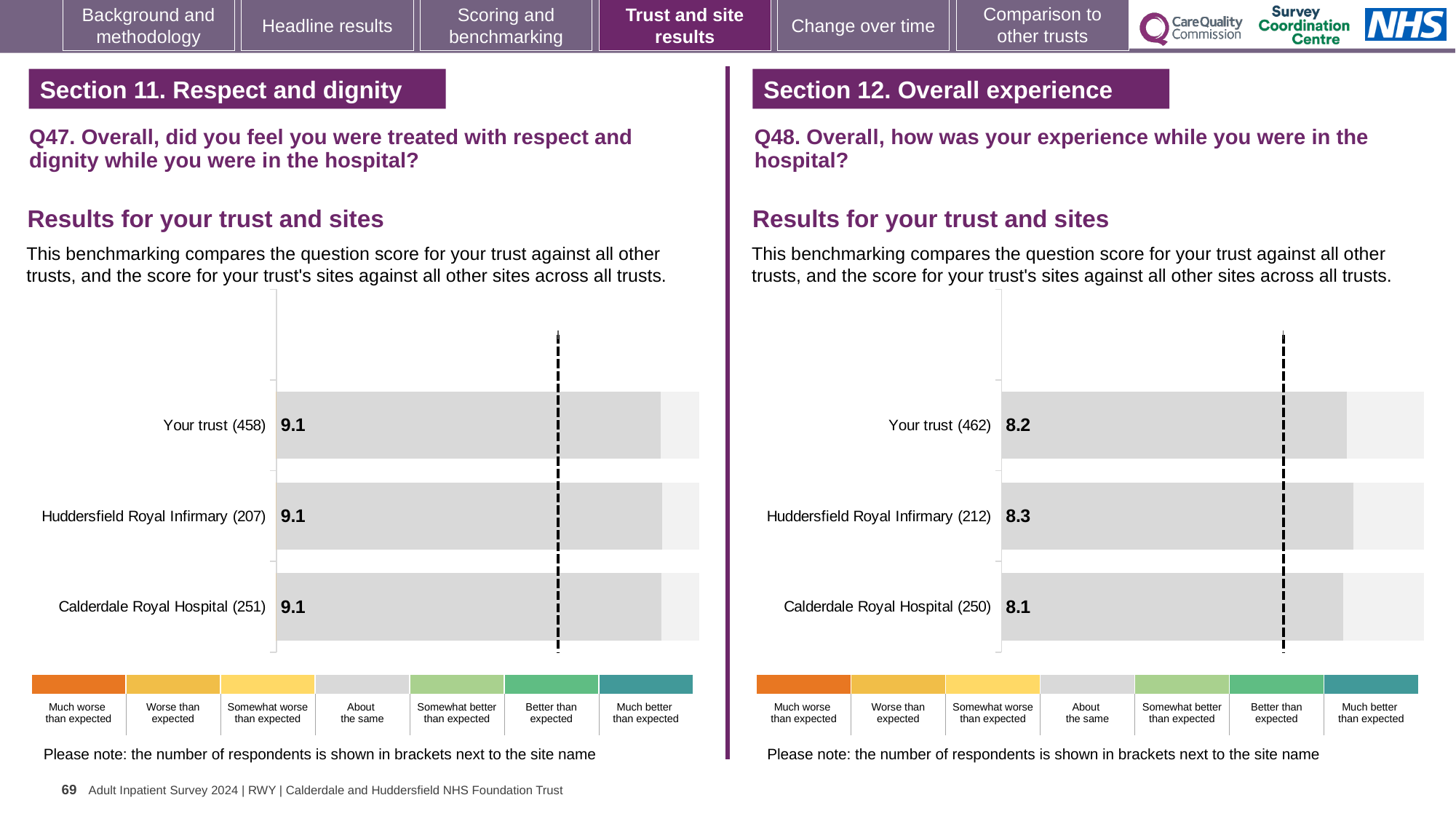
On the Q47 chart (left), how many respondents are shown in brackets for Calderdale Royal Hospital? 251 On the Q47 chart (left), what is the score for Your trust? 9.1 On the Q48 chart (right), which site or trust has the lowest score? Calderdale Royal Hospital On the Q48 chart (right), what is the difference between the scores for Huddersfield Royal Infirmary and Calderdale Royal Hospital? 0.2 On the Q48 chart (right), which has the larger score, Your trust or Huddersfield Royal Infirmary? Huddersfield Royal Infirmary On the Q48 chart (right), what is the score for Your trust? 8.2 On the Q48 chart (right), which site or trust has the highest score? Huddersfield Royal Infirmary How many bars are plotted on the Q47 chart (left)? 3 On the Q48 chart (right), what is the score for Calderdale Royal Hospital? 8.1 On the Q48 chart (right), how many respondents are shown in brackets for Your trust? 462 What type of chart is used for the Q47 results (left)? Bar chart On the Q48 chart (right), what is the score for Huddersfield Royal Infirmary? 8.3